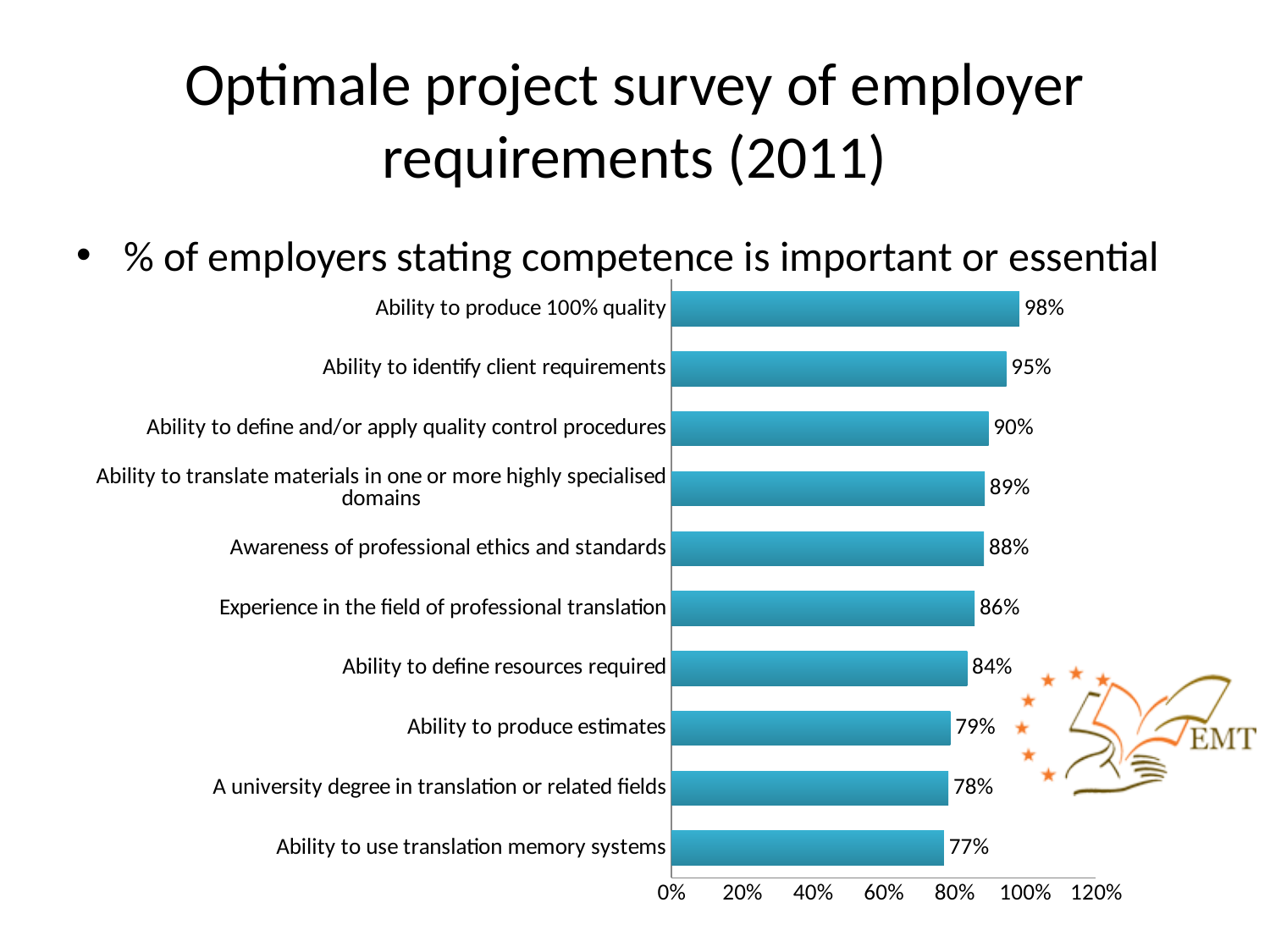
Which has a higher value: 'Ability to define resources required' or 'A university degree in translation or related fields'? Ability to define resources required How many competences (categories) are shown in the chart? 10 What is the value shown for 'Awareness of professional ethics and standards'? 88% What is the highest tick value shown on the horizontal axis? 120% What is the value shown for 'Ability to use translation memory systems'? 77% Which competence has the lowest percentage in the chart? Ability to use translation memory systems What type of chart is shown on the slide? Bar chart Is the value for 'Experience in the field of professional translation' greater or less than 80%? greater What is the value shown for 'Ability to define and/or apply quality control procedures'? 90% What is the difference between the values for 'Ability to identify client requirements' and 'Ability to produce estimates'? 16% Which competence has the highest percentage in the chart? Ability to produce 100% quality What percentage of employers stated that the ability to produce 100% quality is important or essential? 98%